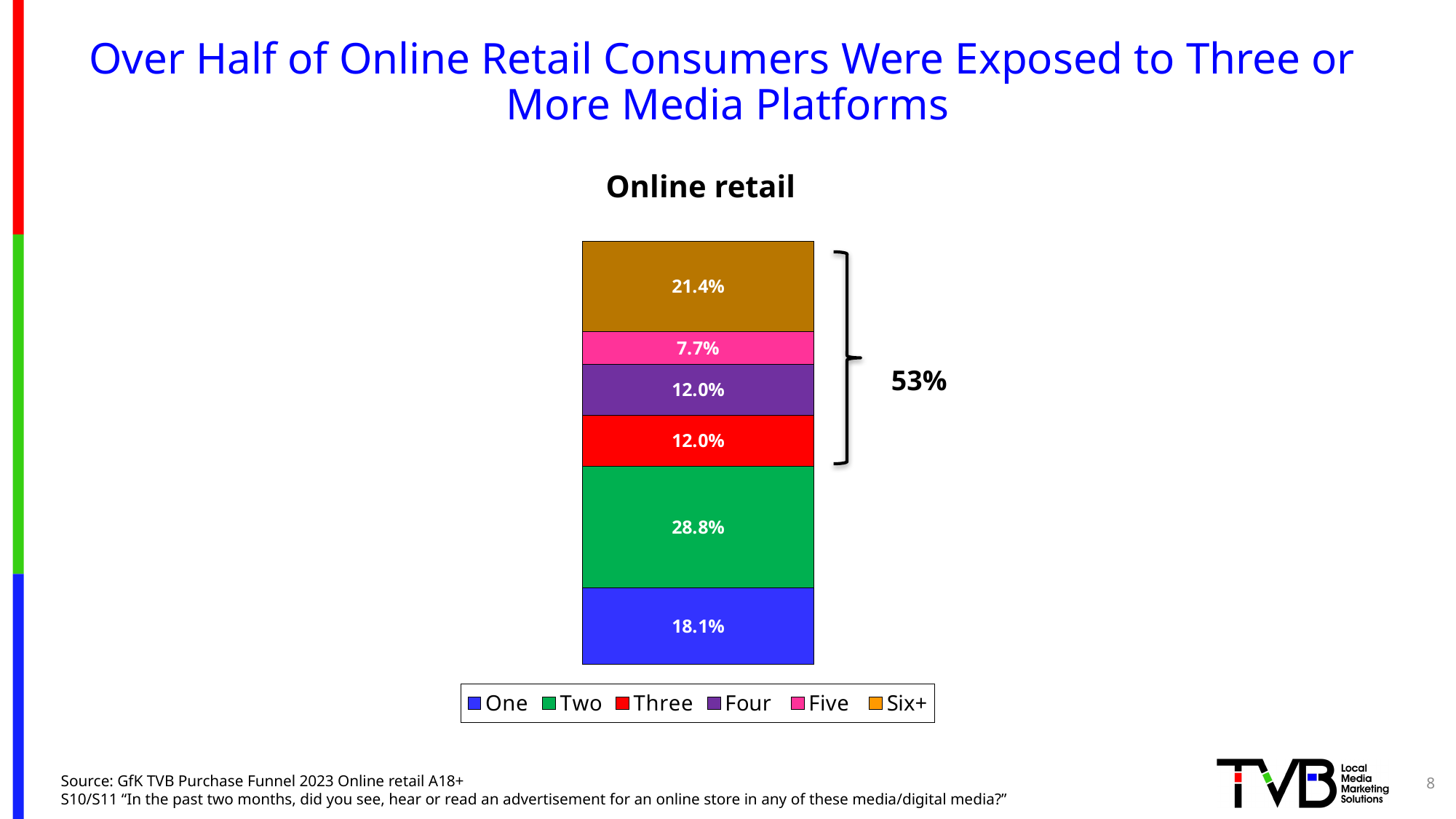
What is the value for the One segment? 18.1% What percentage of online retail consumers were exposed to two media platforms? 28.8% Which segment has the largest share in the Online retail chart? Two How many series does the legend list? 6 Which is larger, the Six+ segment or the One segment? Six+ What combined percentage is shown by the bracket for consumers exposed to three or more media platforms? 53% What is the value for the Six+ segment in the Online retail chart? 21.4% What is the title of the chart? Online retail What is the difference between the Two segment and the One segment? 10.7% What is the value for the Five segment? 7.7% Which segment has the smallest share in the Online retail chart? Five What kind of chart is shown on the slide? Stacked bar chart